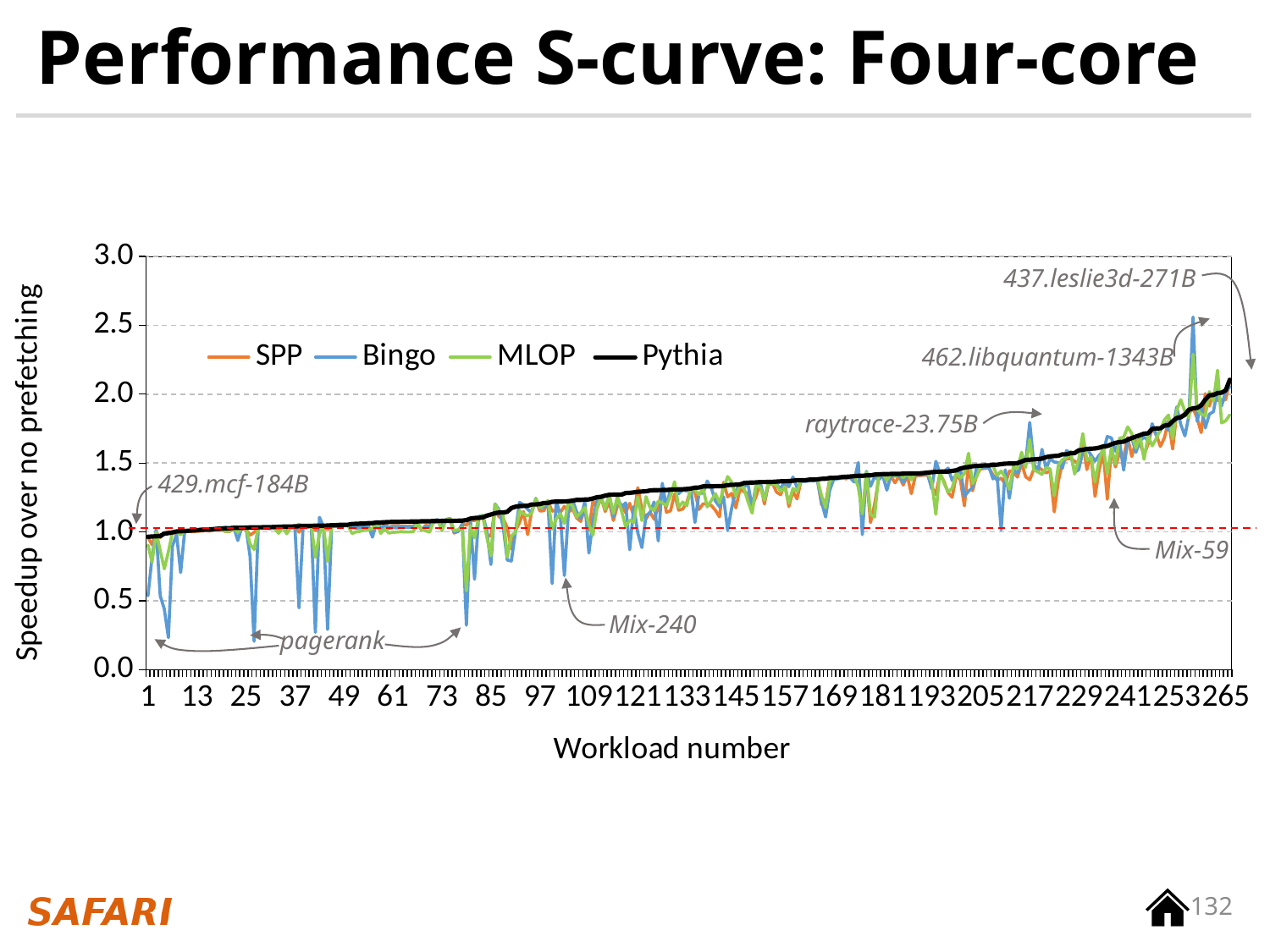
What kind of chart is shown on the slide? line chart Is the lowest dip of the Bingo line in the pagerank region greater or less than 0.5? less What is the largest workload number labelled on the x axis? 265 Does the Pythia line rise or fall as the workload number increases along the x axis? rise How many series does the legend list? 4 At what y value is the red dashed horizontal line drawn? 1.0 What is the label of the y axis? Speedup over no prefetching Is the highest peak of the Bingo line (near workload 259) greater or less than 2.0? greater Which series are listed in the legend? SPP, Bingo, MLOP, Pythia Is the value of the Pythia line at workload number 1 greater or less than 1.5? less What is the title of the chart on the slide? Performance S-curve: Four-core What is the maximum value shown on the y axis? 3.0